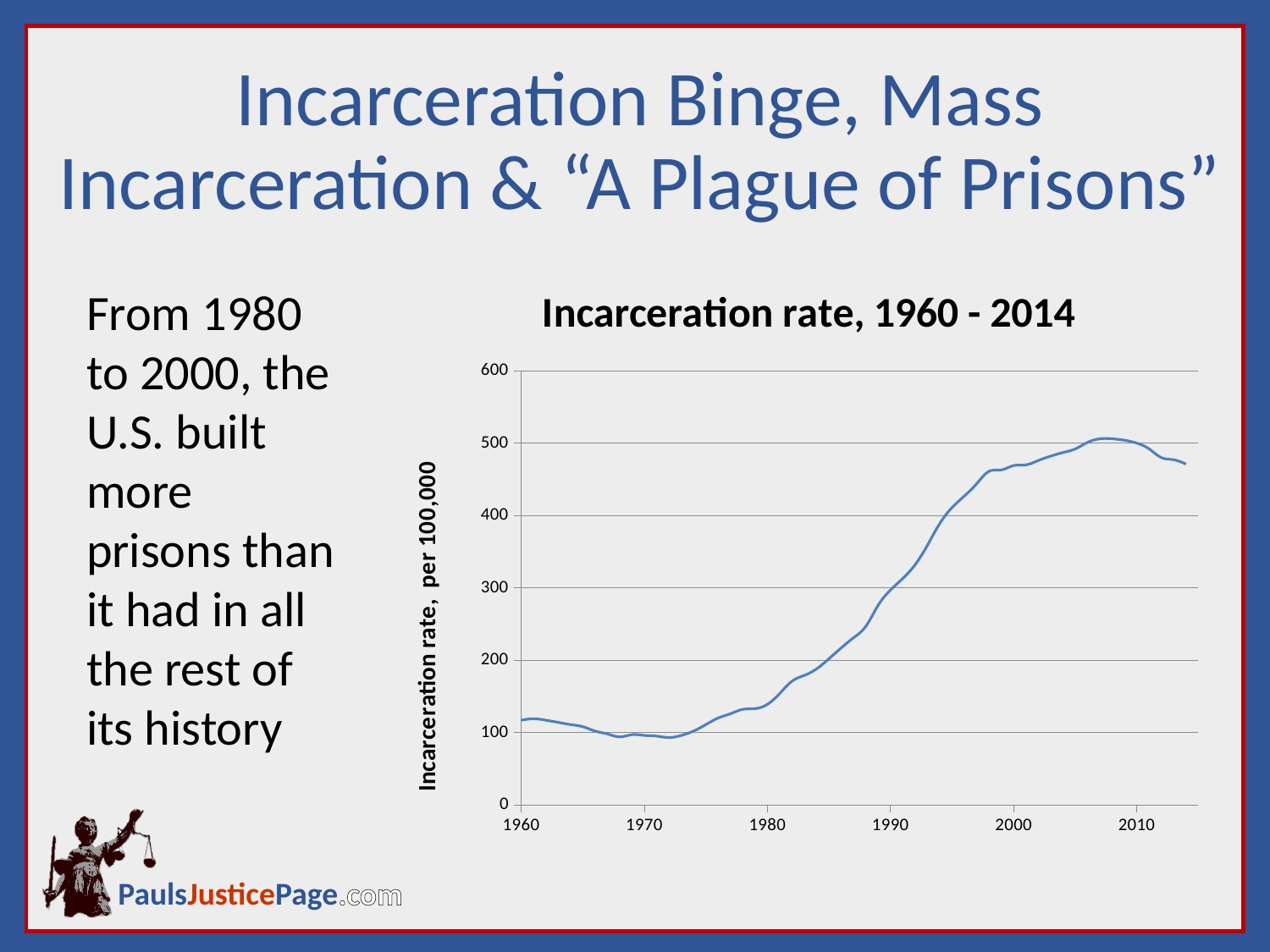
What kind of chart is shown on the slide? line chart Is the incarceration rate in 1980 greater or less than 100? greater Is the incarceration rate in 2000 greater or less than 400? greater Does the incarceration rate rise or fall between 2010 and 2014? fall What is the title of the chart? Incarceration rate, 1960 - 2014 Is the incarceration rate in 1990 greater or less than 200? greater Which year has the higher incarceration rate, 1980 or 2000? 2000 Does the incarceration rate rise or fall between 1980 and 2000? rise What is the label on the vertical axis of the chart? Incarceration rate, per 100,000